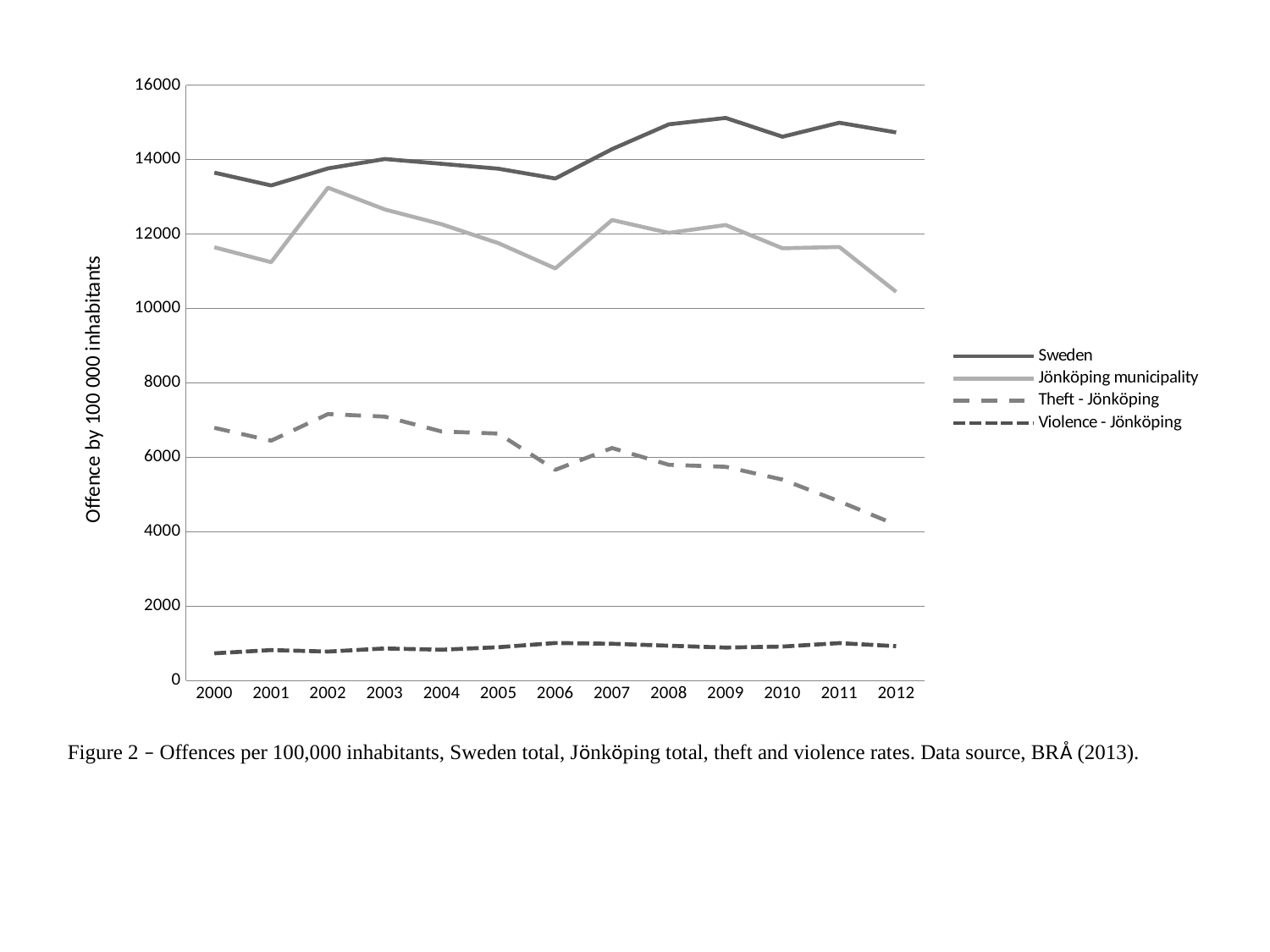
How many years are shown along the x axis? 13 Is the value for Violence - Jönköping in 2006 greater or less than 2000? less How many series does the legend list? 4 Do the values for Theft - Jönköping rise or fall from 2002 to 2012? fall Is the value for Jönköping municipality in 2012 greater or less than 12000? less In which year is the value for Jönköping municipality highest? 2002 In 2008, which is larger: the value for Sweden or the value for Jönköping municipality? Sweden Is the value for Theft - Jönköping in 2002 greater or less than 6000? greater What kind of chart is shown on the slide? line chart What is the title of the y axis? Offence by 100 000 inhabitants Which series has the lowest values across all years? Violence - Jönköping